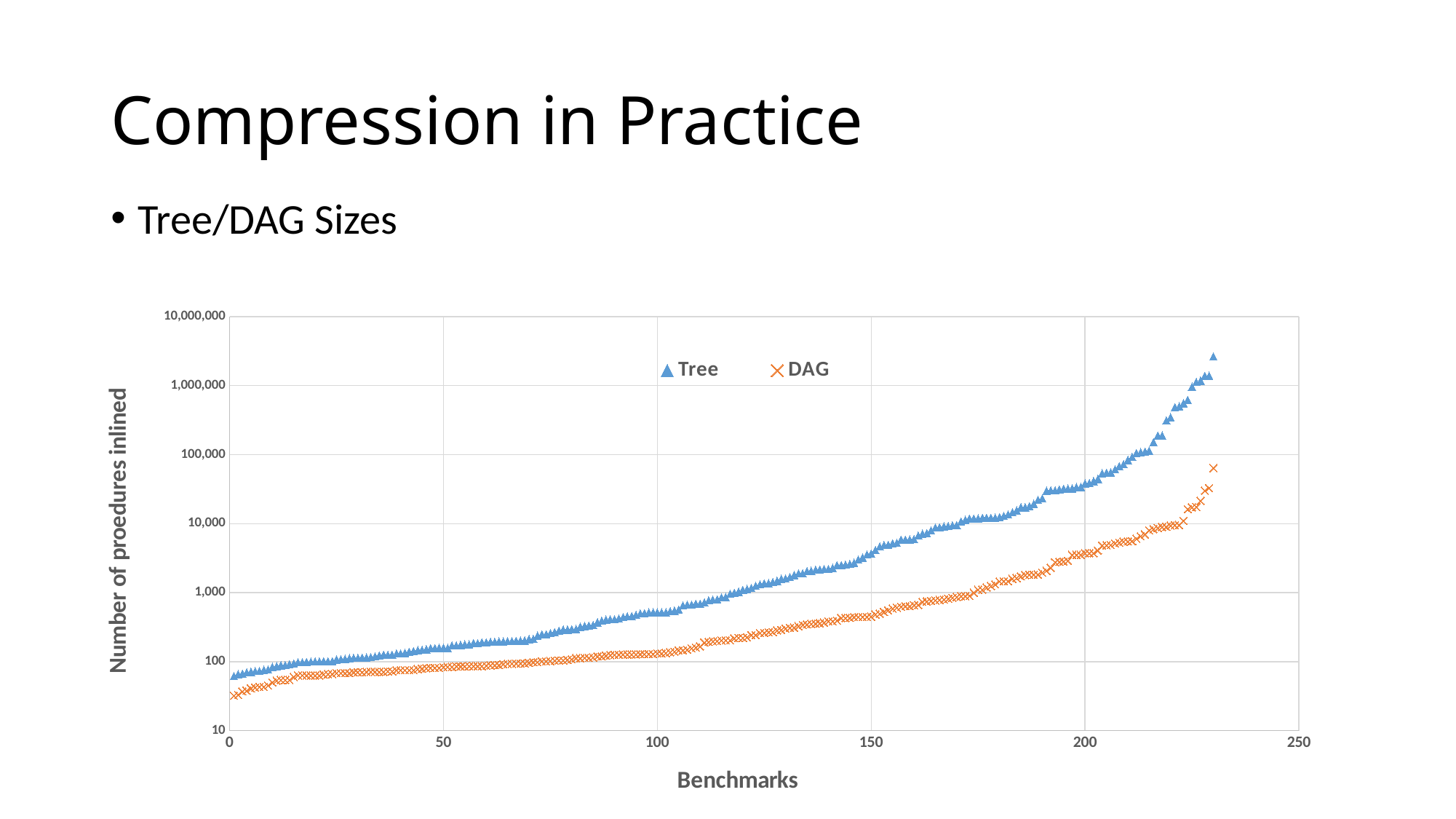
Do the Tree values rise or fall as the benchmark index increases along the x axis? rise Is the highest DAG value greater or less than 100,000? less What is the label of the chart's y axis? Number of proedures inlined What kind of chart is shown on the slide? scatter chart Is the Tree value at benchmark 100 greater or less than 100? greater Which series reaches the highest value on the chart, Tree or DAG? Tree Is the highest Tree value greater or less than 1,000,000? greater What are the two series named in the chart's legend? Tree and DAG Do the DAG values rise or fall along the x axis? rise How many series does the chart's legend list? 2 Which series has the larger value at benchmark 150, Tree or DAG? Tree